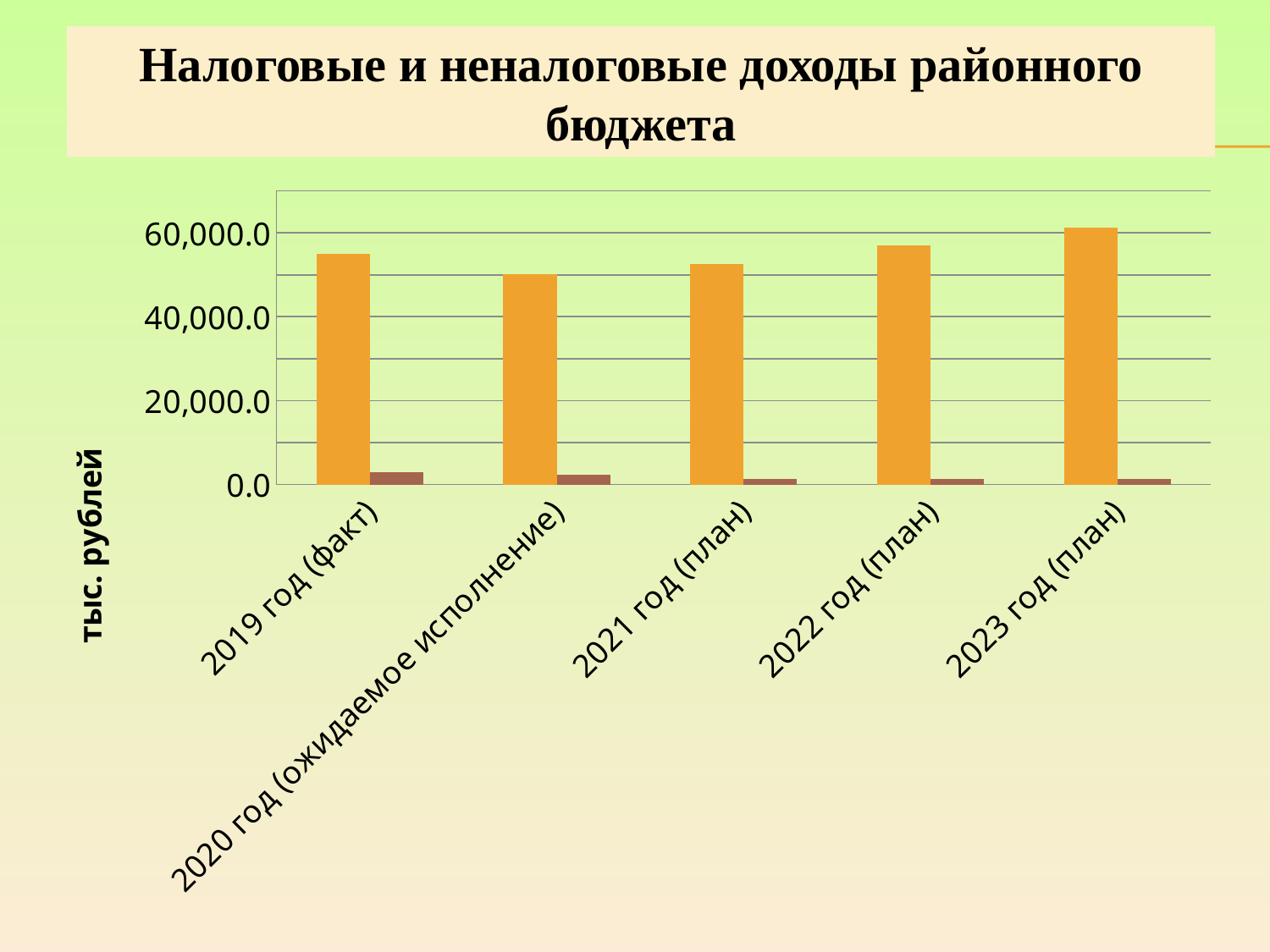
What type of chart is shown on the slide? bar chart Is the orange bar for 2019 год (факт) greater or less than 40,000.0? greater Which orange bar is taller: 2019 год (факт) or 2020 год (ожидаемое исполнение)? 2019 год (факт) Is the brown bar for 2019 год (факт) greater or less than 20,000.0? less Which category has the shortest orange bar? 2020 год (ожидаемое исполнение) Is the orange bar for 2022 год (план) greater or less than 40,000.0? greater Which orange bar is taller: 2021 год (план) or 2022 год (план)? 2022 год (план) What is the title of the chart? Налоговые и неналоговые доходы районного бюджета How many categories are shown on the x axis of the chart? 5 Which category has the tallest orange bar? 2023 год (план) What is the label of the vertical axis? тыс. рублей